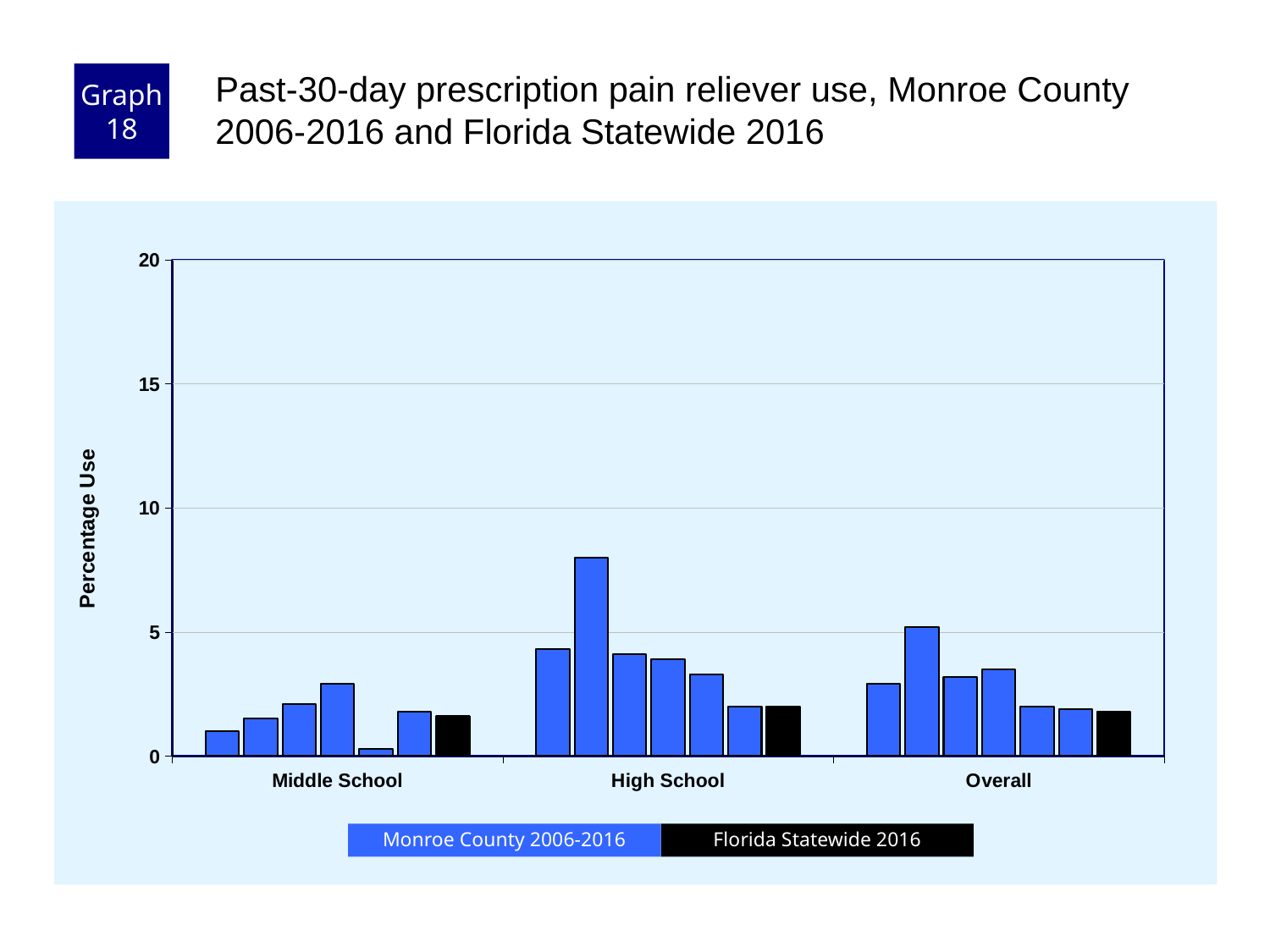
Which is larger for Overall: the tallest Monroe County 2006-2016 bar or the Florida Statewide 2016 bar? Monroe County 2006-2016 Which x-axis category contains the tallest bar in the chart? High School Is the tallest Monroe County 2006-2016 bar for High School greater or less than 5? greater Is the Florida Statewide 2016 value for Middle School greater or less than 5? less Is the tallest bar in the whole chart greater or less than 10? less How many series does the legend list? 2 Which is larger: the tallest Monroe County bar for High School or the tallest Monroe County bar for Middle School? High School What kind of chart is shown on the slide? bar chart What colour represents Florida Statewide 2016 in the legend? black How many categories are shown along the x axis? 3 What is the label on the y axis? Percentage Use